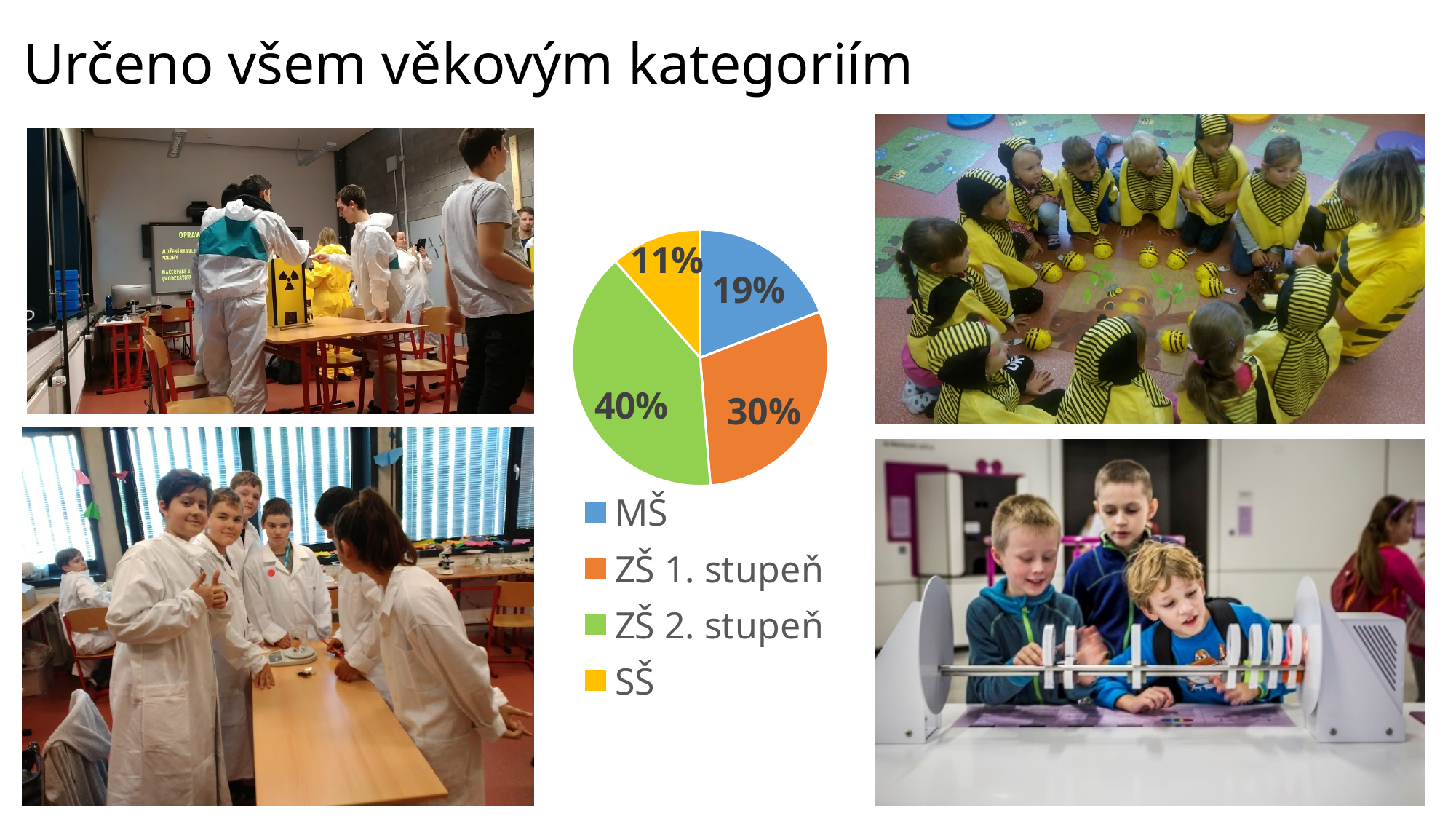
What share of the pie chart does ZŠ 1. stupeň represent? 30% What share of the pie chart does MŠ represent? 19% What is the difference in percentage points between ZŠ 2. stupeň and ZŠ 1. stupeň? 10 percentage points Which category has the smallest slice of the pie chart? SŠ What is the combined share of MŠ and SŠ? 30% How many categories does the pie chart show? 4 Which category has the largest slice of the pie chart? ZŠ 2. stupeň What share of the pie chart does SŠ represent? 11% What colour is the slice for ZŠ 1. stupeň? Orange Which is larger, the share for MŠ or the share for SŠ? MŠ What share of the pie chart does ZŠ 2. stupeň represent? 40% What type of chart is shown on the slide? Pie chart